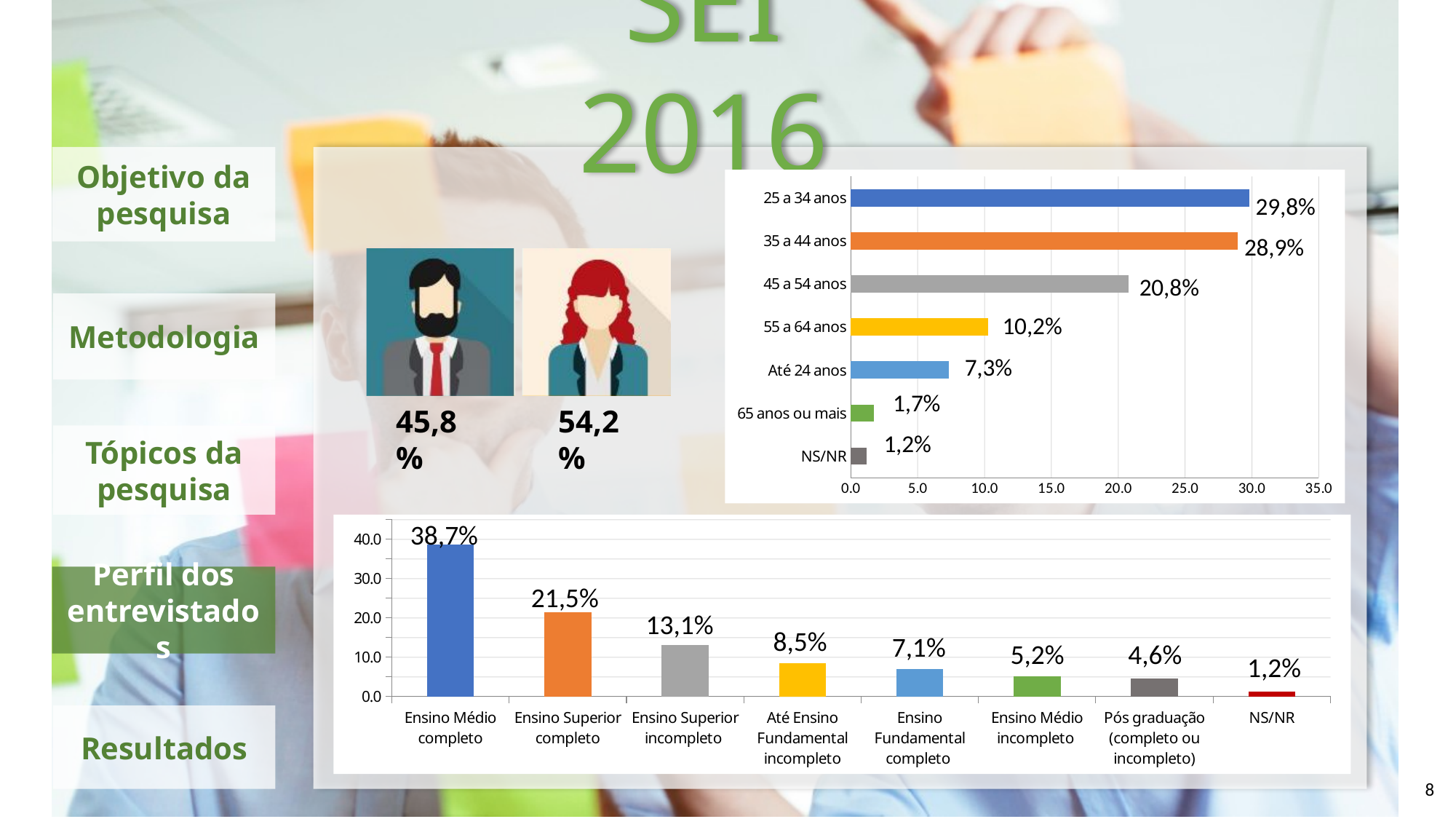
In the horizontal bar chart at the top right of the slide, what is the difference between the values for '45 a 54 anos' and '55 a 64 anos'? 10,6 percentage points In the horizontal bar chart at the top right of the slide, what is the value for '55 a 64 anos'? 10,2% In the horizontal bar chart at the top right of the slide, what is the value for '25 a 34 anos'? 29,8% In the vertical bar chart at the bottom of the slide, what is the difference between the values for 'Ensino Médio completo' and 'Ensino Superior completo'? 17,2 percentage points In the horizontal bar chart at the top right of the slide, which is larger: the value for 'Até 24 anos' or for '65 anos ou mais'? Até 24 anos In the vertical bar chart at the bottom of the slide, do the values rise or fall from left to right along the x axis? fall In the horizontal bar chart at the top right of the slide, how many categories are plotted? 7 In the vertical bar chart at the bottom of the slide, which category has the highest value? Ensino Médio completo In the vertical bar chart at the bottom of the slide, what is the value for 'Ensino Superior completo'? 21,5% In the vertical bar chart at the bottom of the slide, how many categories are plotted? 8 In the horizontal bar chart at the top right of the slide, which age category has the lowest value? NS/NR What kind of chart is the chart at the bottom of the slide? bar chart